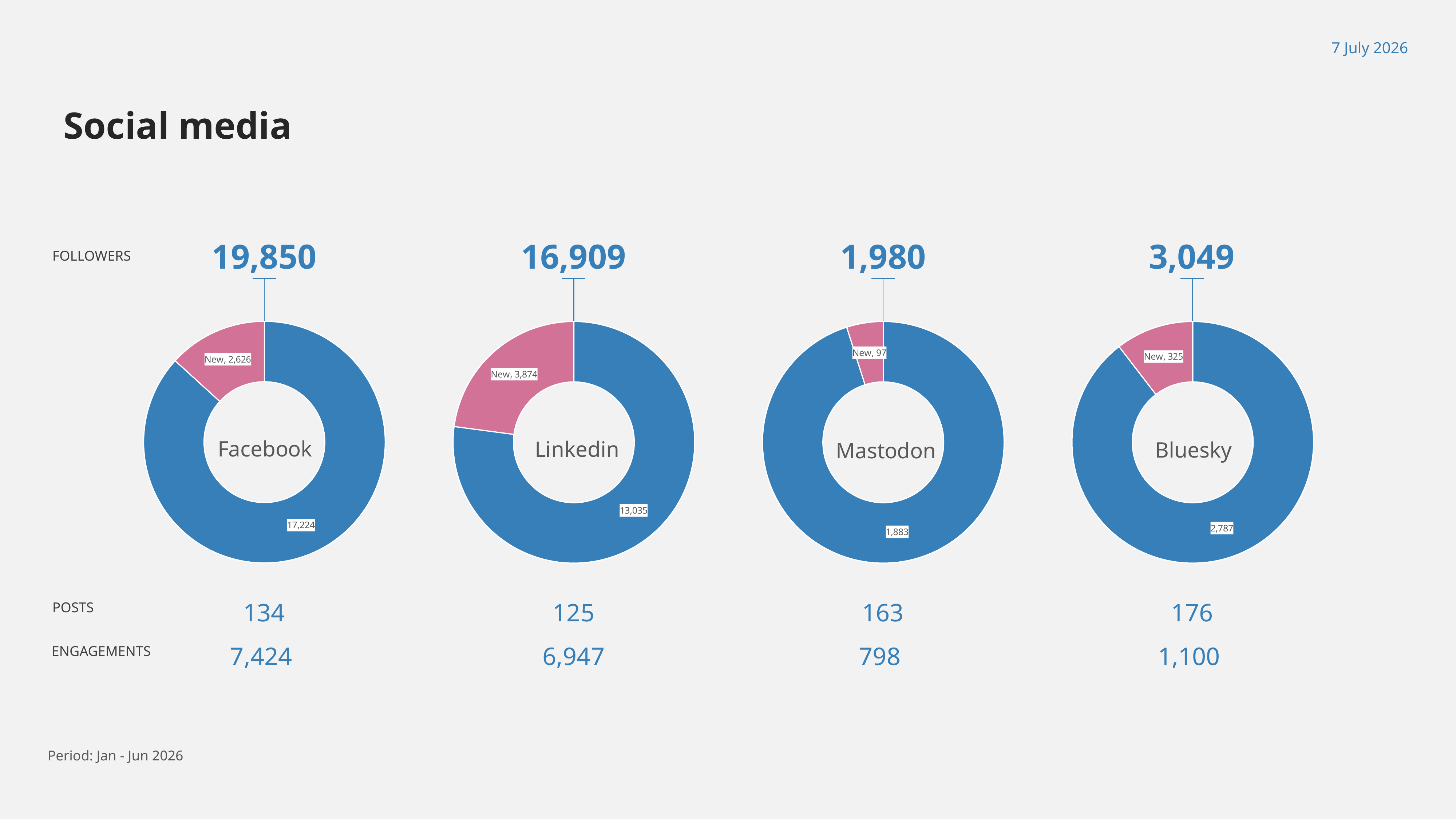
In the Facebook chart, what is the difference between the blue slice (17,224) and the 'New' slice (2,626)? 14,598 In the Facebook chart, what is the value of the 'New' slice? 2,626 What is the total number of followers shown above the Facebook chart? 19,850 What kind of chart is used for each social media platform on this slide? Donut (pie) chart In the Linkedin chart, what is the value of the 'New' slice? 3,874 Which platform's chart has the largest 'New' slice value? Linkedin In the Bluesky chart, what is the value of the 'New' slice? 325 Is the 'New' slice in the Linkedin chart larger or smaller than the 'New' slice in the Bluesky chart? Larger How many donut charts are shown on the slide? 4 Which platform's chart has the smallest 'New' slice value? Mastodon In the Mastodon chart, what is the value of the larger (blue) slice? 1,883 What colour is used for the 'New' slice in each donut chart? Pink